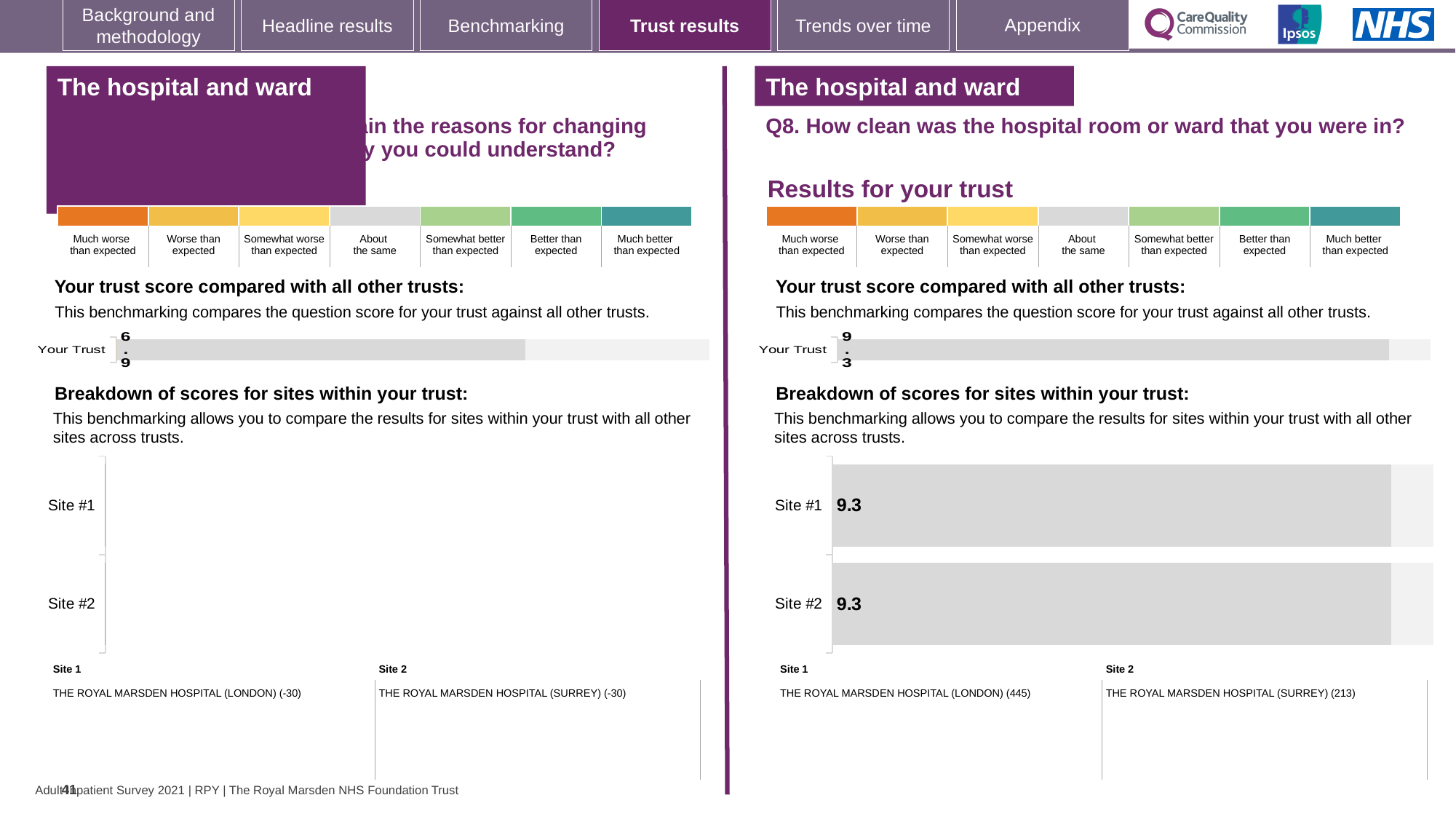
Which is larger: the Your Trust score on the left-hand chart or the Your Trust score on the right-hand chart (Q8)? The right-hand chart (Q8) On the right-hand 'Your trust score compared with all other trusts' chart (Q8), what is the score shown for Your Trust? 9.3 On the right-hand site breakdown chart (Q8), how many sites are plotted? 2 On the right-hand site breakdown chart (Q8), is the score for Site #1 greater or less than 9? greater On the right-hand chart (Q8), which hospital is listed as Site 1? THE ROYAL MARSDEN HOSPITAL (LONDON) (445) Which survey question does the right-hand chart relate to? Q8. How clean was the hospital room or ward that you were in? What kind of chart is the right-hand site breakdown chart (Q8)? Bar chart On the right-hand site breakdown chart (Q8), is the score for Site #1 larger than, smaller than, or equal to the score for Site #2? Equal On the left-hand 'Your trust score compared with all other trusts' chart, what is the score shown for Your Trust? 6.9 On the right-hand chart (Q8, breakdown of scores for sites within your trust), what is the score for Site #2? 9.3 On the right-hand chart (Q8, breakdown of scores for sites within your trust), what is the score for Site #1? 9.3 What is the difference between the Your Trust score on the right-hand chart (Q8) and the Your Trust score on the left-hand chart? 2.4